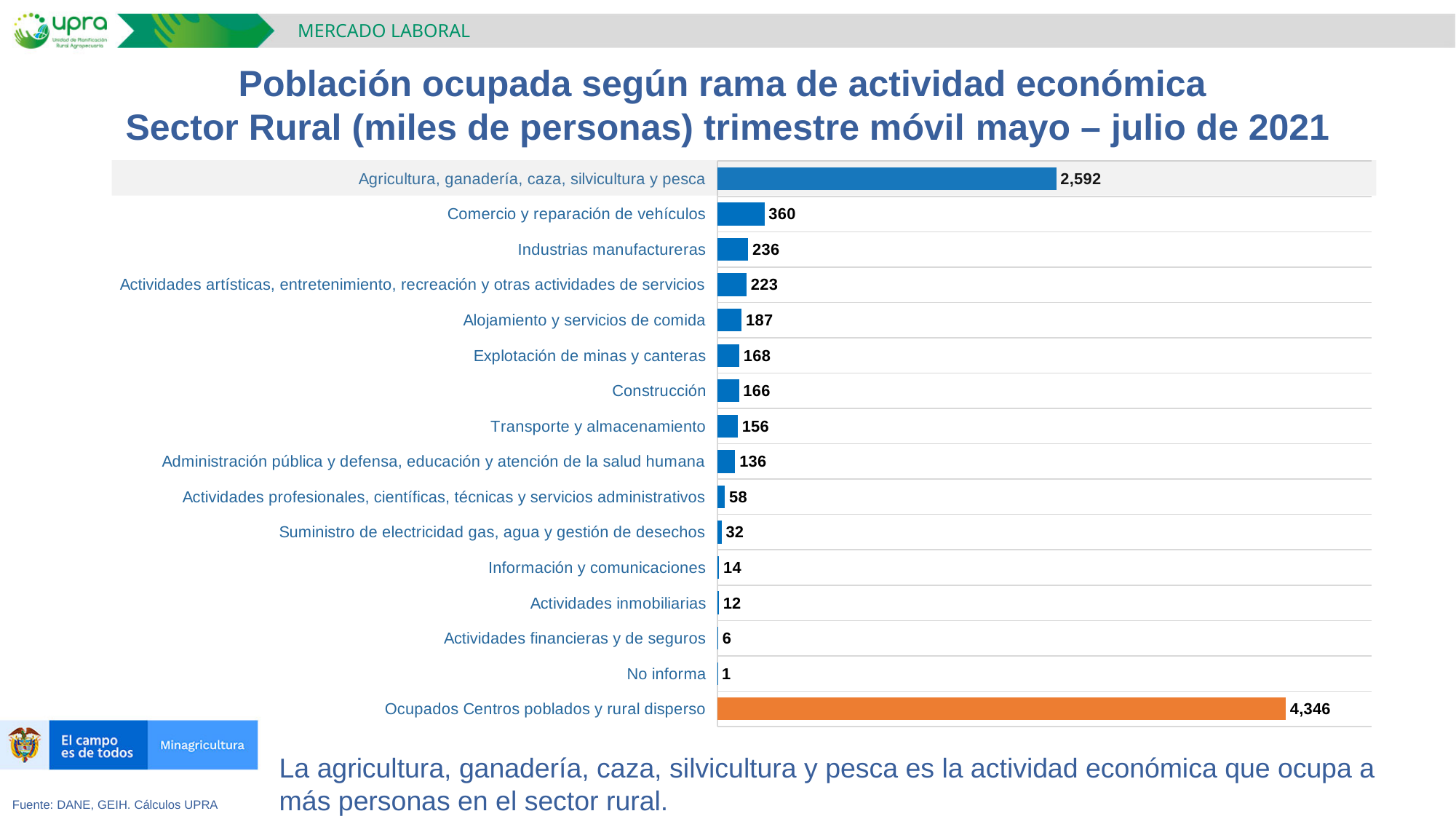
What is the value for Comercio y reparación de vehículos? 360 What is the difference between the values for Comercio y reparación de vehículos and Industrias manufactureras? 124 Which category has the highest value in the chart? Ocupados Centros poblados y rural disperso What is the value for Ocupados Centros poblados y rural disperso? 4,346 What kind of chart is shown on the slide? Bar chart What is the value for Actividades financieras y de seguros? 6 What is the value for Agricultura, ganadería, caza, silvicultura y pesca? 2,592 Which category has the lowest value in the chart? No informa Which is larger, the value for Alojamiento y servicios de comida or the value for Transporte y almacenamiento? Alojamiento y servicios de comida How many categories are shown in the chart? 16 What is the value for Construcción? 166 What colour is the bar for Ocupados Centros poblados y rural disperso? Orange